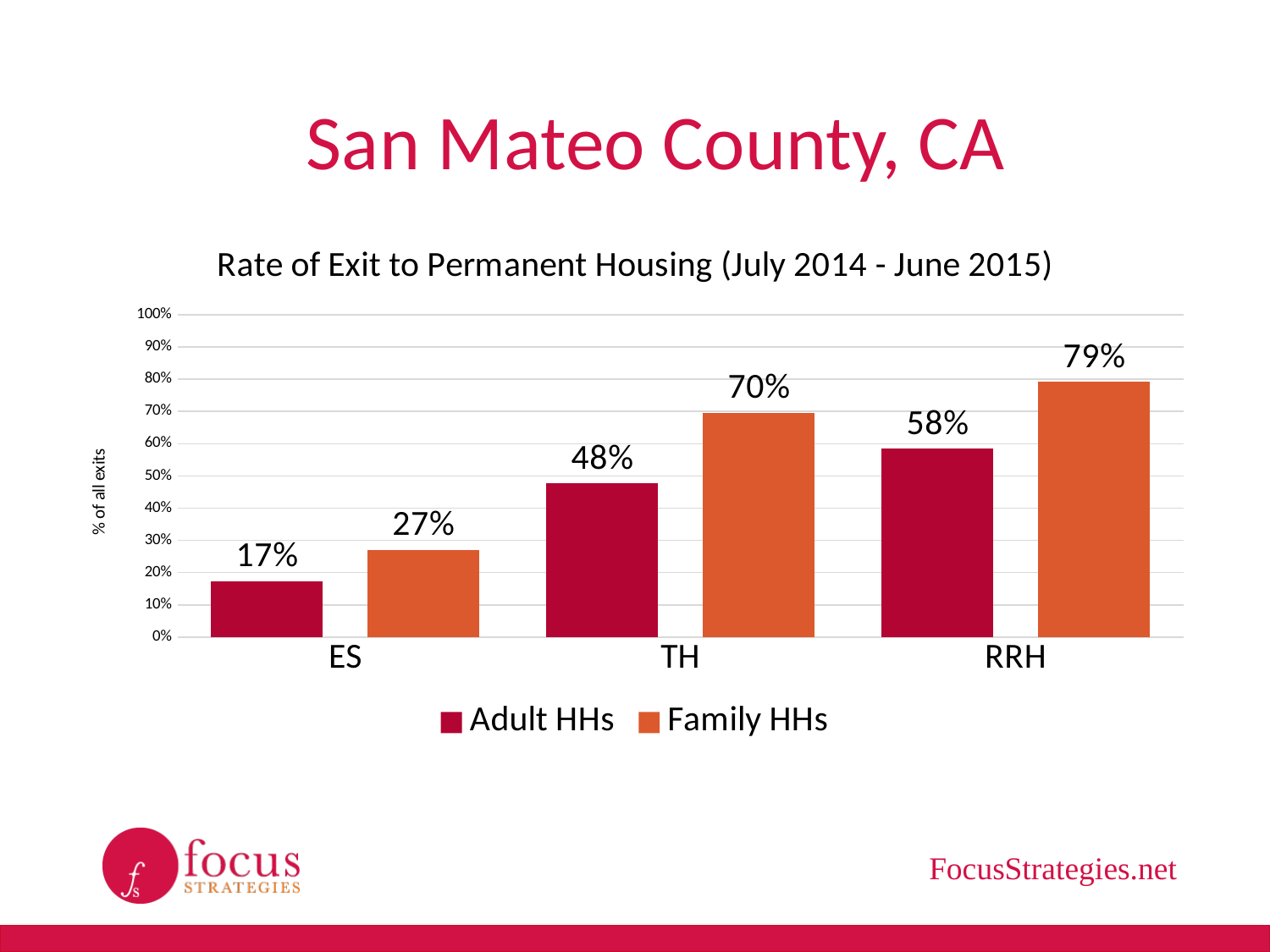
How many program types are shown on the x axis? 3 What is the rate of exit to permanent housing for Adult HHs in RRH? 58% What is the difference between the Adult HHs exit rates for TH and ES? 31% What is the difference between the Family HHs and Adult HHs exit rates for RRH? 21% Which program type has the highest rate of exit to permanent housing for Family HHs? RRH Which program type has the lowest rate of exit to permanent housing for Adult HHs? ES Do the Family HHs exit rates rise or fall from ES to RRH? Rise What is the rate of exit to permanent housing for Family HHs in TH? 70% How many series does the legend list? 2 Which is larger, the Family HHs exit rate for ES or the Adult HHs exit rate for TH? Adult HHs exit rate for TH What is the rate of exit to permanent housing for Adult HHs in ES? 17% What kind of chart is shown on the slide? Bar chart